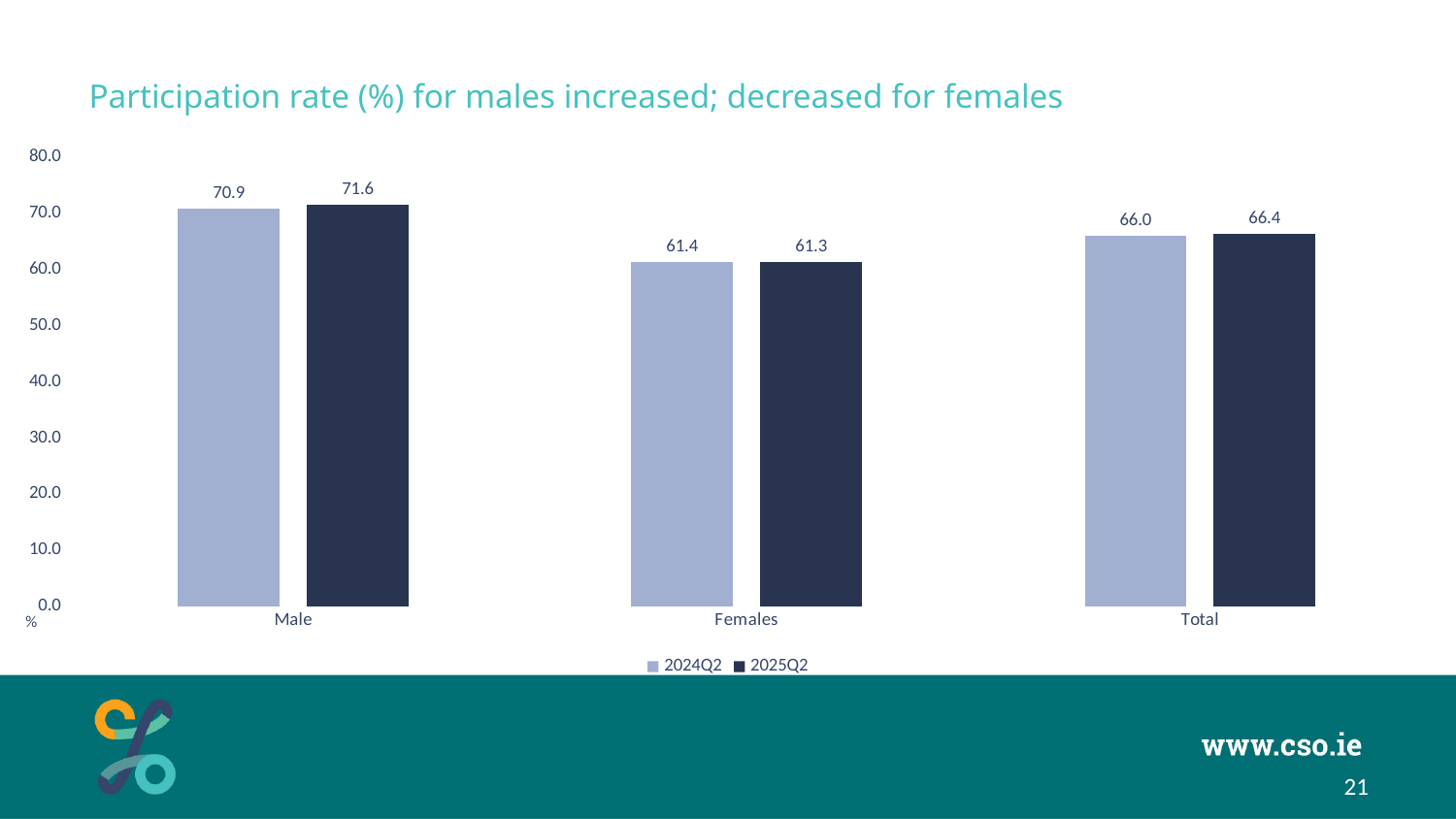
What is the Total participation rate in 2025Q2? 66.4 How many categories are shown on the x axis? 3 Is the Total participation rate in 2024Q2 greater or less than 60.0? greater How many series does the legend list? 2 Which category has the highest participation rate in 2024Q2? Male What is the difference between the male participation rate in 2025Q2 and 2024Q2? 0.7 What is the participation rate for males in 2025Q2? 71.6 Which category has the lowest participation rate in 2025Q2? Females What kind of chart is shown on the slide? Bar chart What is the title of the chart? Participation rate (%) for males increased; decreased for females What is the participation rate for females in 2024Q2? 61.4 What is the difference between the male and female participation rates in 2024Q2? 9.5